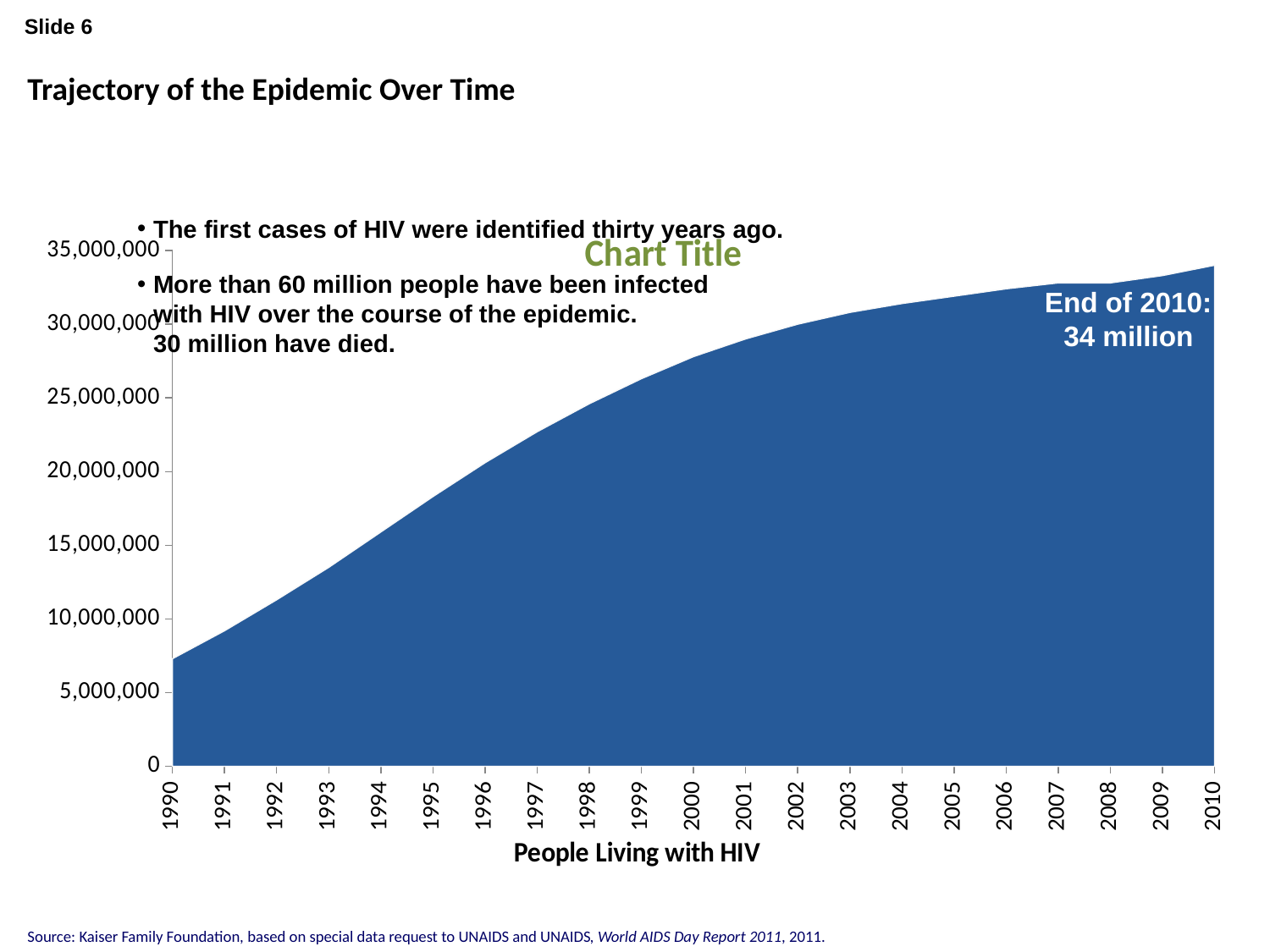
What is the label shown beneath the x axis of the chart? People Living with HIV Is the value for 2005 greater or less than 25,000,000? greater What kind of chart is shown on the slide? area chart Which year has the larger value, 1995 or 2000? 2000 Which year has the highest value in the chart? 2010 How many years are plotted along the x axis of the chart? 21 Is the value for 1993 greater or less than 10,000,000? greater Is the value for 1990 greater or less than 10,000,000? less Which year has the lowest value in the chart? 1990 According to the annotation on the chart, how many people were living with HIV at the end of 2010? 34 million Do the values in the chart rise or fall from 1990 to 2010? rise